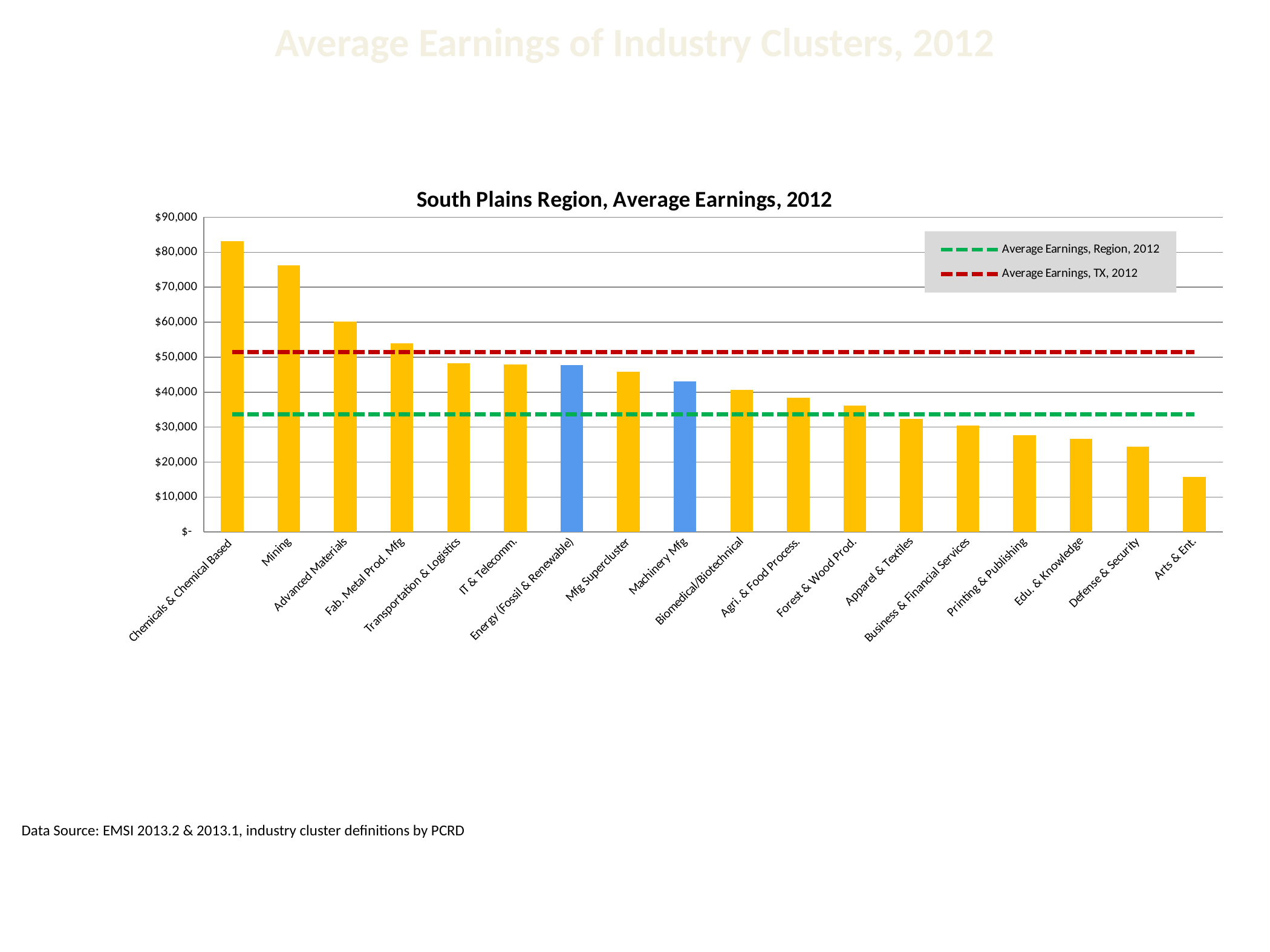
What is the title of the chart? South Plains Region, Average Earnings, 2012 Is the value for Printing & Publishing greater or less than $30,000? less What kind of chart is shown on the slide? bar chart Which has higher average earnings, Mining or Advanced Materials? Mining Is the value for Chemicals & Chemical Based greater or less than $80,000? greater How many entries does the chart's legend list? 2 Which industry cluster has the lowest average earnings? Arts & Ent. Which industry cluster has the highest average earnings? Chemicals & Chemical Based Is the value for Mining greater or less than $70,000? greater Do the bar values rise or fall moving from left to right along the x axis? fall How many industry clusters are plotted as bars in the chart? 18